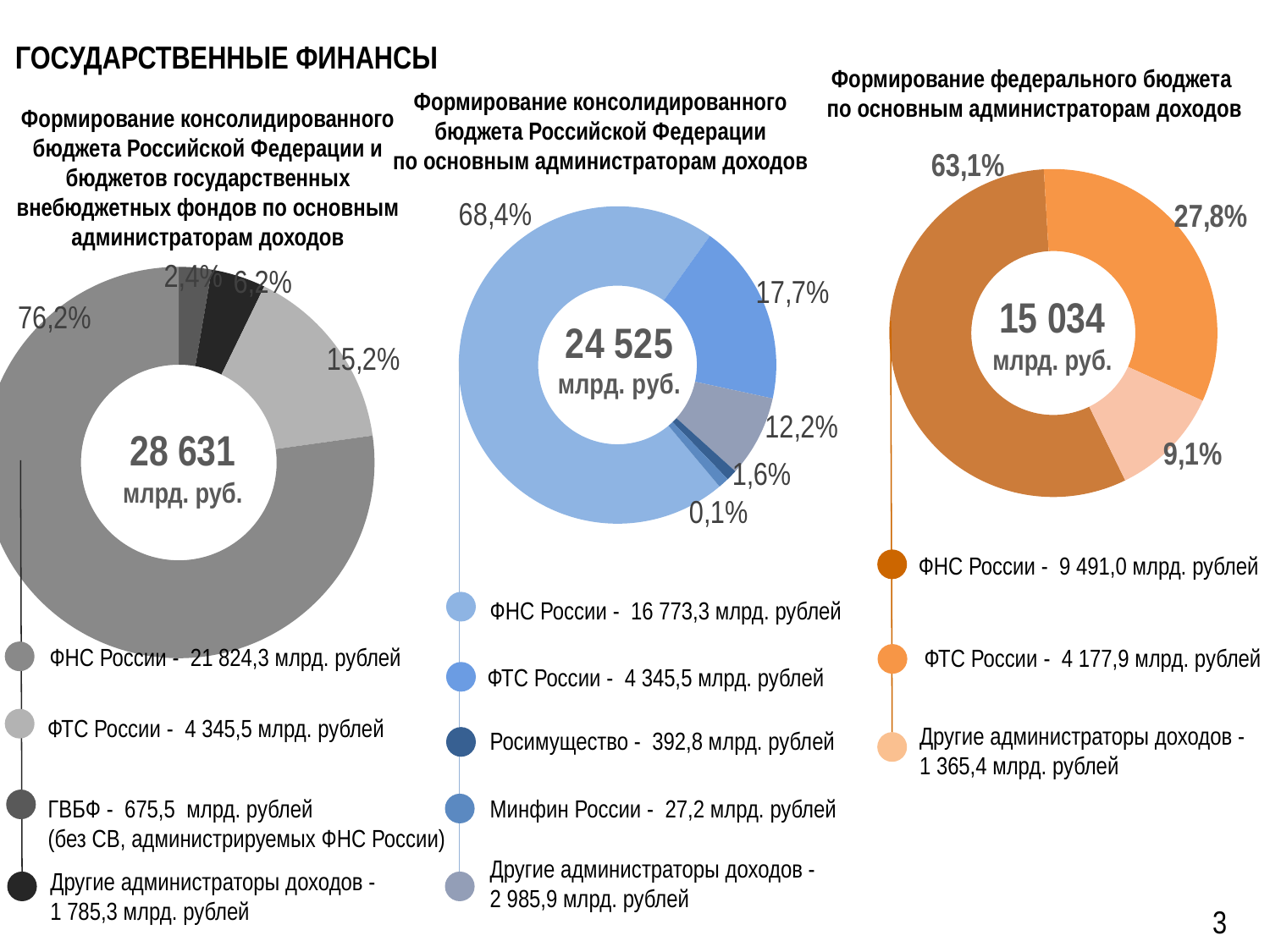
On the middle chart (консолидированный бюджет Российской Федерации по основным администраторам доходов), what share does ФНС России account for? 68,4% How many donut charts are shown on the slide? 3 What kind of chart is used on the right side of the slide for the federal budget? Donut (pie) chart On the left chart (консолидированный бюджет и бюджеты государственных внебюджетных фондов), which administrator has the largest share? ФНС России On the left chart (консолидированный бюджет и бюджеты государственных внебюджетных фондов), what is the difference between the values for ФНС России and ФТС России? 17 478,8 млрд. рублей On the middle chart (консолидированный бюджет Российской Федерации по основным администраторам доходов), what is the value for Росимущество? 392,8 млрд. рублей On the chart titled 'Формирование федерального бюджета по основным администраторам доходов', what total is shown in the centre of the donut? 15 034 млрд. руб. On the left chart (консолидированный бюджет и бюджеты государственных внебюджетных фондов), what is the value for ГВБФ? 675,5 млрд. рублей On the chart titled 'Формирование федерального бюджета по основным администраторам доходов', what is the value for ФНС России? 9 491,0 млрд. рублей On the chart titled 'Формирование федерального бюджета по основным администраторам доходов', what share of the total does ФТС России account for? 27,8% On the middle chart (консолидированный бюджет Российской Федерации по основным администраторам доходов), which administrator has the smallest share? Минфин России On the middle chart (консолидированный бюджет Российской Федерации по основным администраторам доходов), how many categories does the legend list? 5